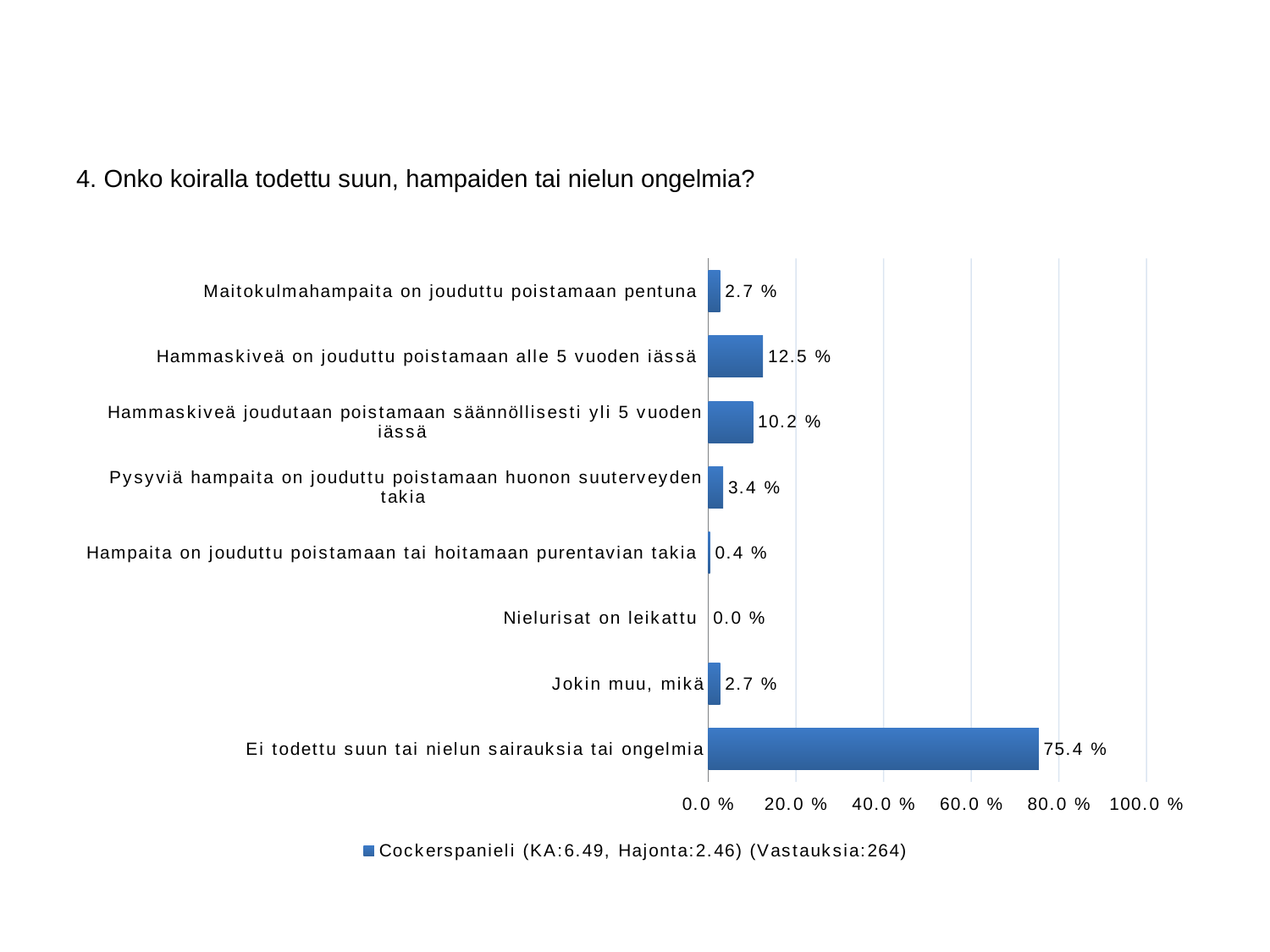
What is the difference between "Hammaskiveä on jouduttu poistamaan alle 5 vuoden iässä" and "Hammaskiveä joudutaan poistamaan säännöllisesti yli 5 vuoden iässä"? 2.3 % Which category has the lowest value? Nielurisat on leikattu What is the value for "Hampaita on jouduttu poistamaan tai hoitamaan purentavian takia"? 0.4 % Is the value for "Ei todettu suun tai nielun sairauksia tai ongelmia" greater or less than 60.0 %? greater Which category has the highest value? Ei todettu suun tai nielun sairauksia tai ongelmia What is the value for "Hammaskiveä on jouduttu poistamaan alle 5 vuoden iässä"? 12.5 % What is the value for "Pysyviä hampaita on jouduttu poistamaan huonon suuterveyden takia"? 3.4 % What is the value for "Ei todettu suun tai nielun sairauksia tai ongelmia"? 75.4 % What kind of chart is shown on the slide? bar chart How many categories are shown in the chart? 8 How many responses (Vastauksia) does the legend report? 264 Which is larger: "Pysyviä hampaita on jouduttu poistamaan huonon suuterveyden takia" or "Jokin muu, mikä"? Pysyviä hampaita on jouduttu poistamaan huonon suuterveyden takia